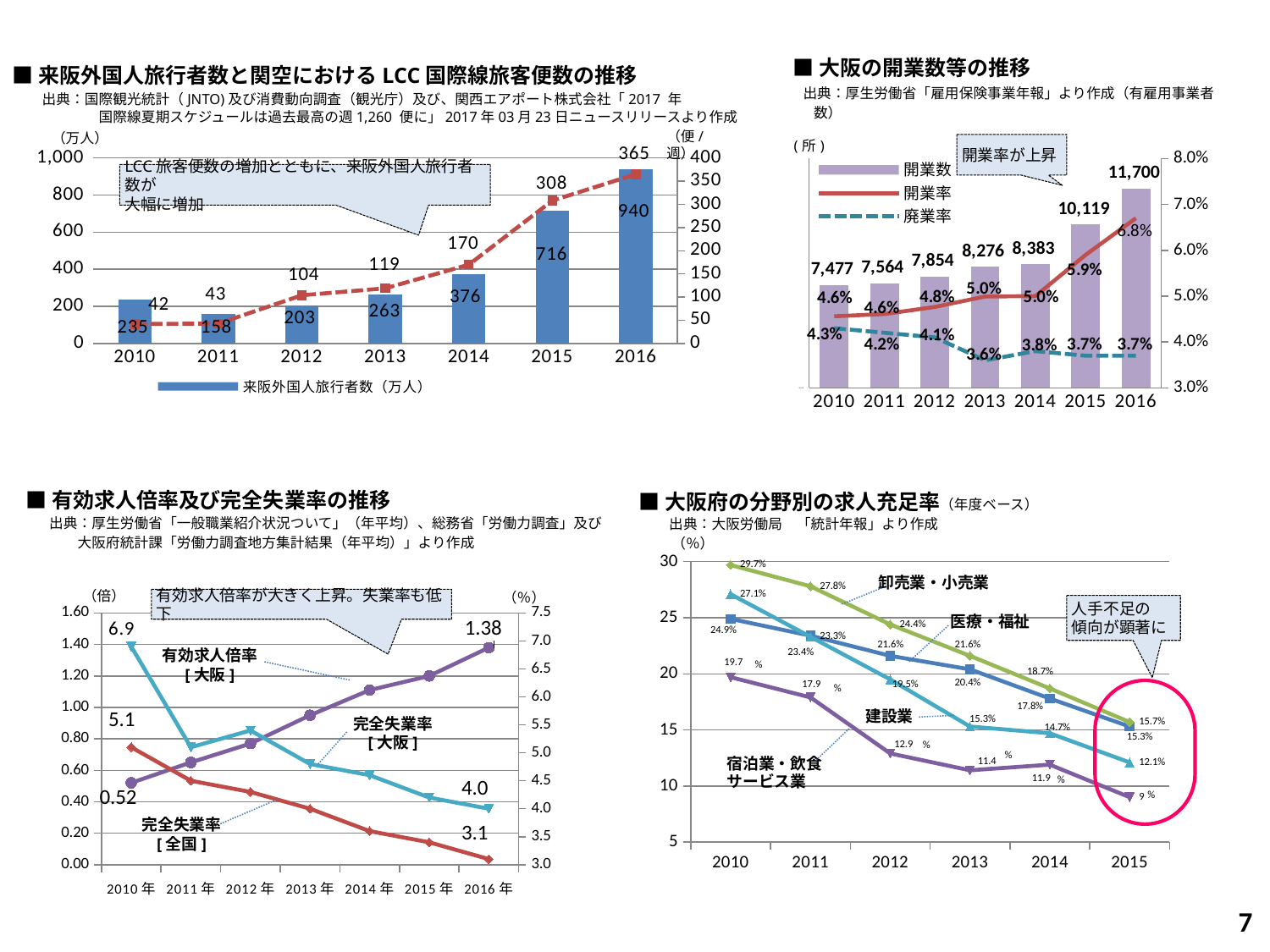
In the chart titled 有効求人倍率及び完全失業率の推移, what is the 有効求人倍率 [大阪] value for 2016年? 1.38 In the chart titled 大阪府の分野別の求人充足率, which sector has the lowest value in 2015? 宿泊業・飲食サービス業 In the chart titled 来阪外国人旅行者数と関空におけるLCC国際線旅客便数の推移, what is the value of the dashed line for 2013? 119 In the chart titled 大阪の開業数等の推移, which year has the lowest 廃業率 value? 2013 In the chart titled 来阪外国人旅行者数と関空におけるLCC国際線旅客便数の推移, what is the value of the bar for 2016? 940 In the chart titled 大阪の開業数等の推移, what is the bar value for 2015? 10,119 In the chart titled 来阪外国人旅行者数と関空におけるLCC国際線旅客便数の推移, what is the difference between the bar values for 2015 and 2014? 340 In the chart titled 有効求人倍率及び完全失業率の推移, what is the 完全失業率 [全国] value for 2016年? 3.1 In the chart titled 大阪府の分野別の求人充足率, what is the 卸売業・小売業 value for 2010? 29.7% In the chart titled 大阪の開業数等の推移, what is the 開業率 value for 2016? 6.8% In the chart titled 大阪の開業数等の推移, how many series does the legend list? 3 In the chart titled 来阪外国人旅行者数と関空におけるLCC国際線旅客便数の推移, which year has the lowest bar value? 2011